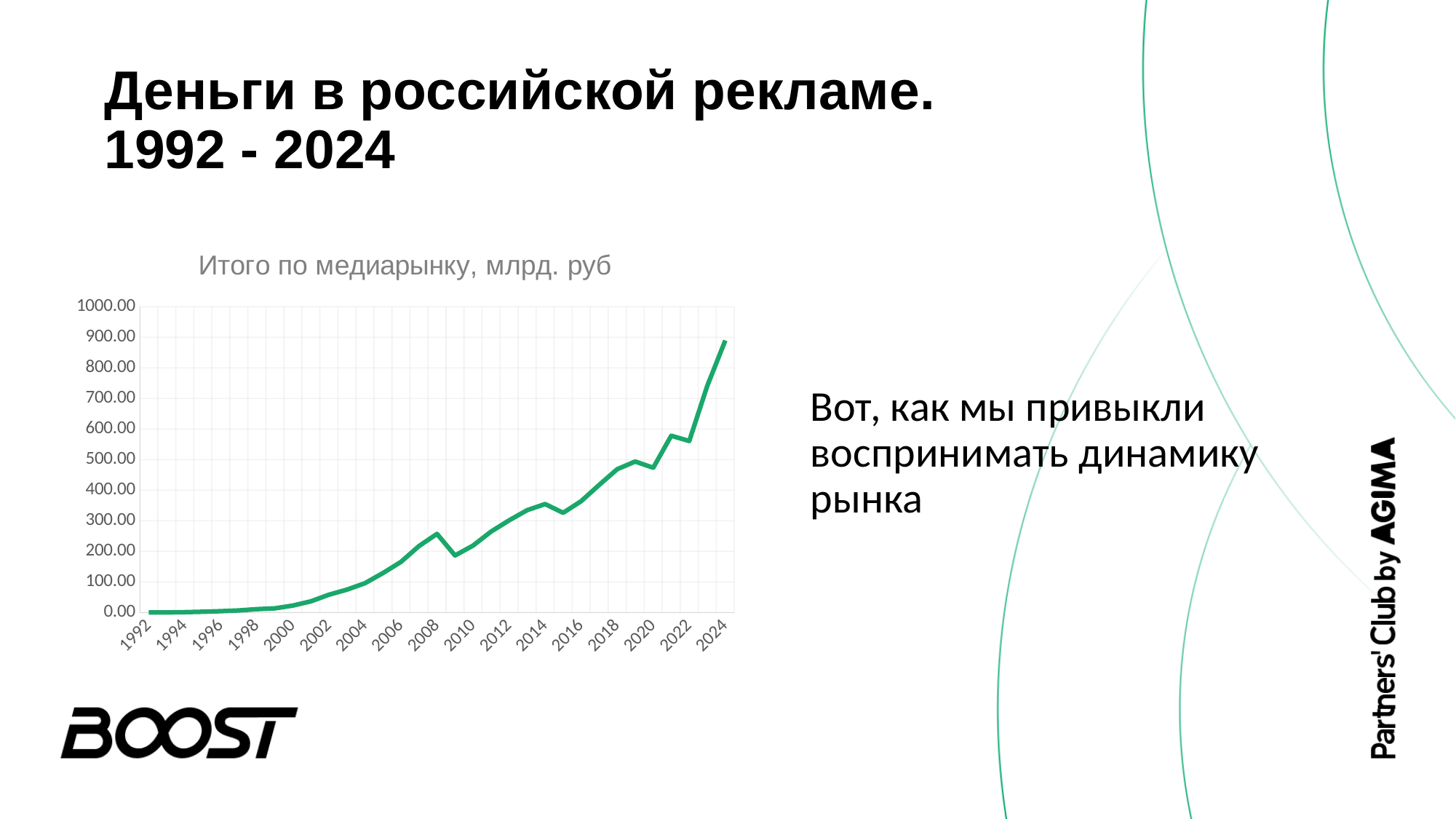
Is the value for 2009 greater or less than 200? less Is the value for 2000 greater or less than 100? less Which is larger, the value for 2024 or the value for 2022? 2024 Is the value for 2008 greater or less than 200? greater Which year has the highest value on the chart? 2024 What is the title of the chart? Итого по медиарынку, млрд. руб What kind of chart is shown on the slide? line chart Overall, do the values rise or fall from 1992 to 2024? rise Which is larger, the value for 2008 or the value for 2009? 2008 Which year has the lowest value on the chart? 1992